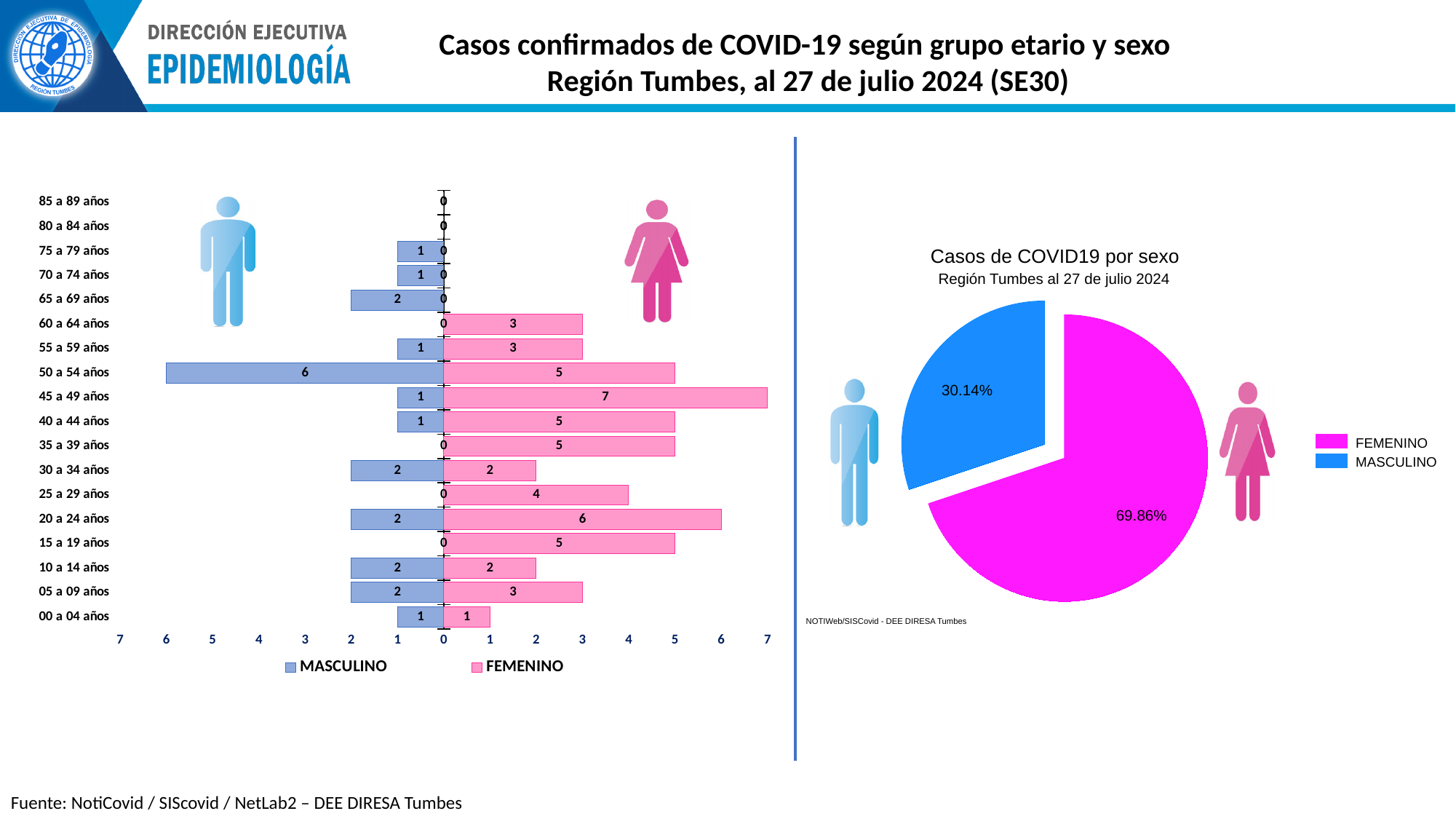
How many series does the legend of the left bar chart list? 2 In the pie chart 'Casos de COVID19 por sexo', which colour represents MASCULINO? Blue In the left bar chart, which is larger for the 50 a 54 años age group, the MASCULINO value or the FEMENINO value? MASCULINO In the pie chart 'Casos de COVID19 por sexo', what share is FEMENINO? 69.86% In the left bar chart, how many age groups are shown on the vertical axis? 18 In the left bar chart, what is the difference between the FEMENINO and MASCULINO values for the 20 a 24 años age group? 4 In the left bar chart, which age group has the highest FEMENINO value? 45 a 49 años In the pie chart 'Casos de COVID19 por sexo', what share is MASCULINO? 30.14% What kind of chart is the chart on the left side of the slide? Bar chart In the left bar chart, which age group has the highest MASCULINO value? 50 a 54 años In the left bar chart, what is the FEMENINO value for the 45 a 49 años age group? 7 In the left bar chart, what is the MASCULINO value for the 50 a 54 años age group? 6